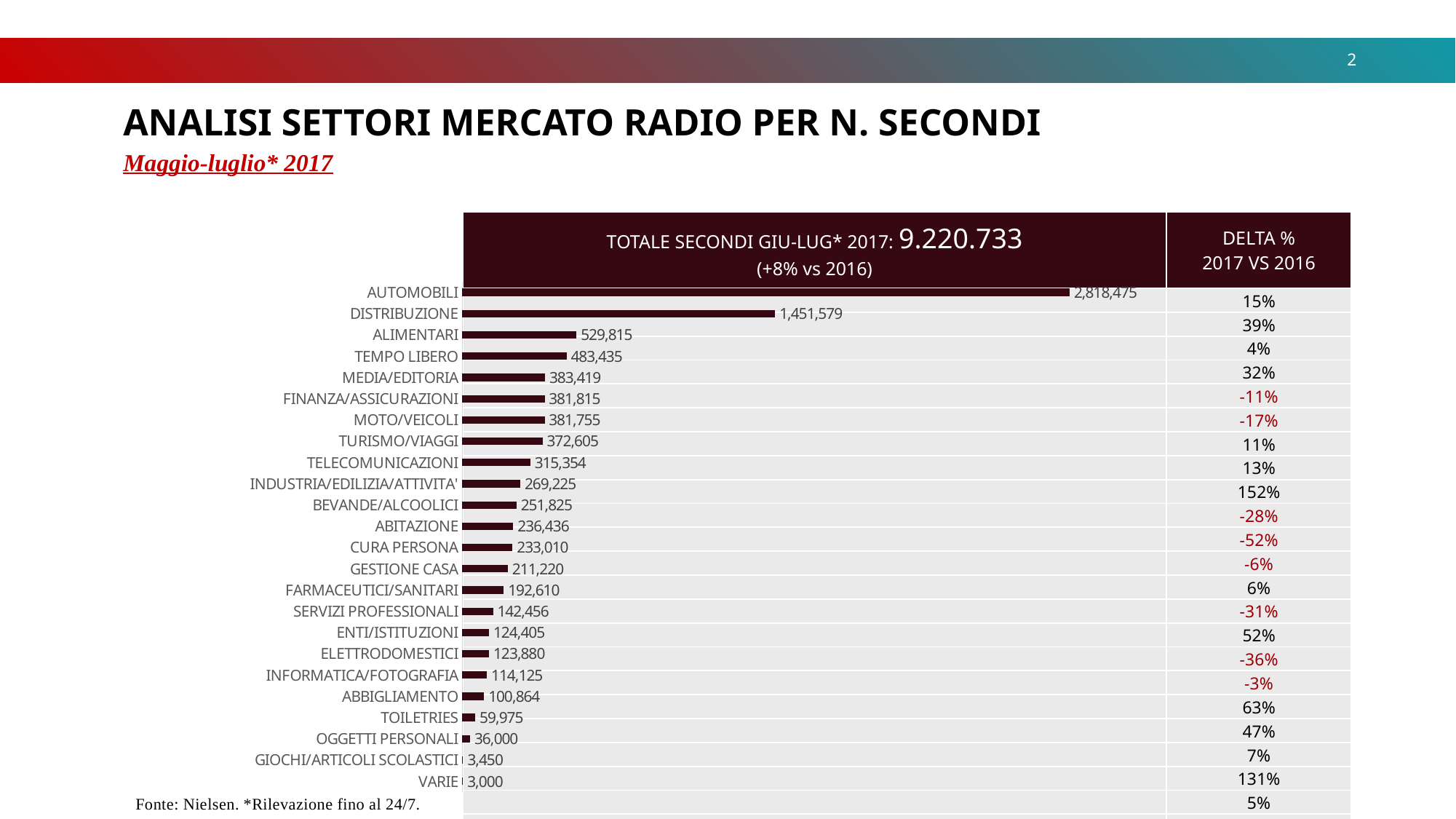
What is the value for AUTOMOBILI? 2,818,475 Which is larger, the value for TOILETRIES or the value for OGGETTI PERSONALI? TOILETRIES Which is larger, the value for DISTRIBUZIONE or the value for ALIMENTARI? DISTRIBUZIONE What is the difference between the values for ALIMENTARI and TEMPO LIBERO? 46,380 What is the difference between the values for AUTOMOBILI and DISTRIBUZIONE? 1,366,896 What is the value for ABBIGLIAMENTO? 100,864 How many categories are shown in the chart? 24 What kind of chart is shown on the slide? bar chart Which category has the lowest value? VARIE What is the value for TELECOMUNICAZIONI? 315,354 What total number of seconds is stated in the chart header for GIU-LUG* 2017? 9.220.733 Which category has the highest value? AUTOMOBILI